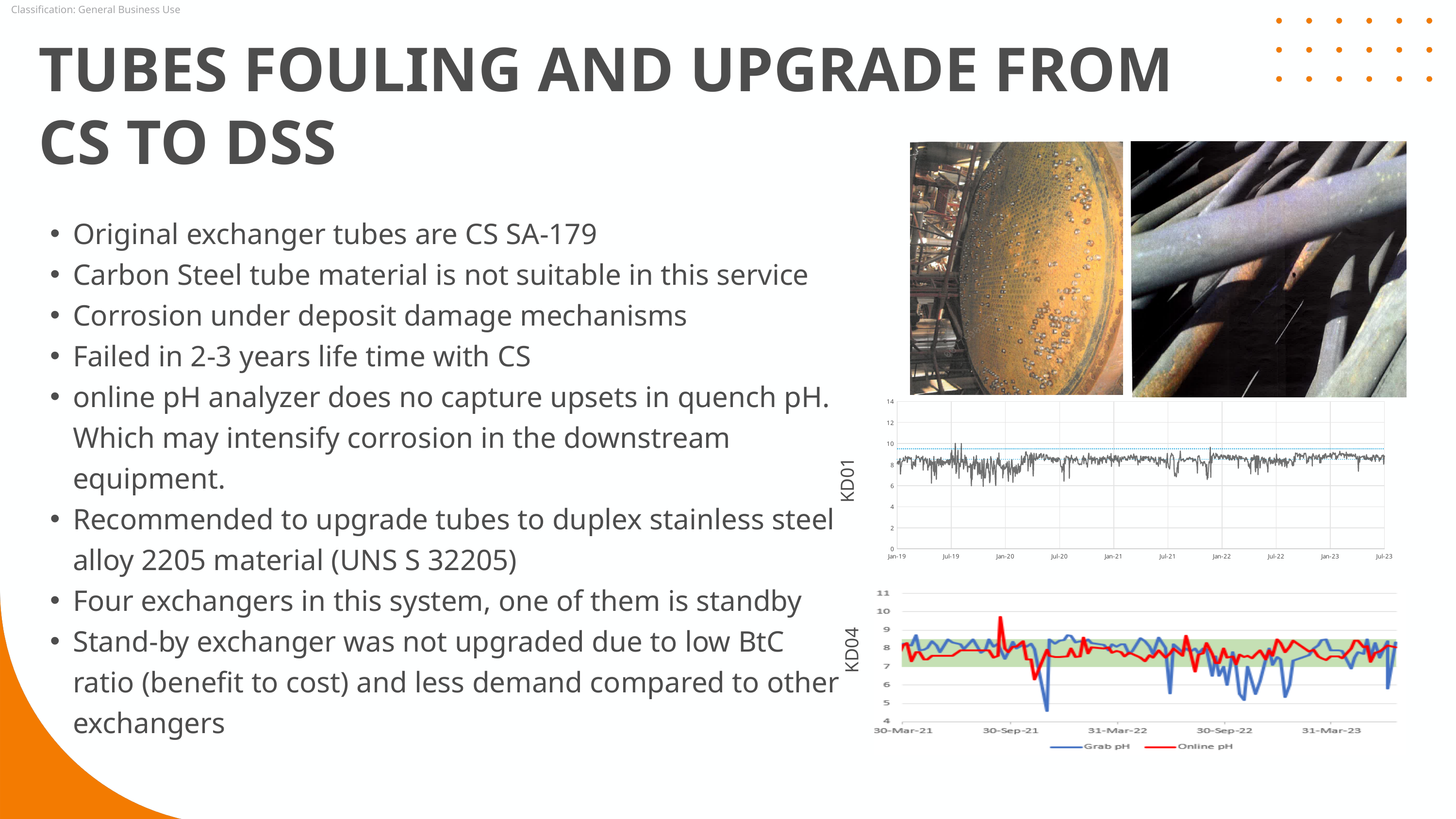
In the KD04 chart, which colour is used for the Online pH series? red In the KD04 chart, which series reaches the lowest value shown, Grab pH or Online pH? Grab pH What are the two series named in the legend of the KD04 chart? Grab pH and Online pH How many series does the legend of the KD04 chart list? 2 What is the first date label on the x axis of the KD01 chart? Jan-19 What kind of chart is the KD01 chart on the right of the slide? line chart In the KD01 chart, is the value around Jul-20 greater or less than 12? less What kind of chart is the KD04 chart at the bottom right of the slide? line chart In the KD01 chart, is the value around Jan-22 greater or less than 4? greater In the KD04 chart, is the peak of the Online pH series near 30-Sep-21 greater or less than 9? greater How many date labels are shown on the x axis of the KD04 chart? 5